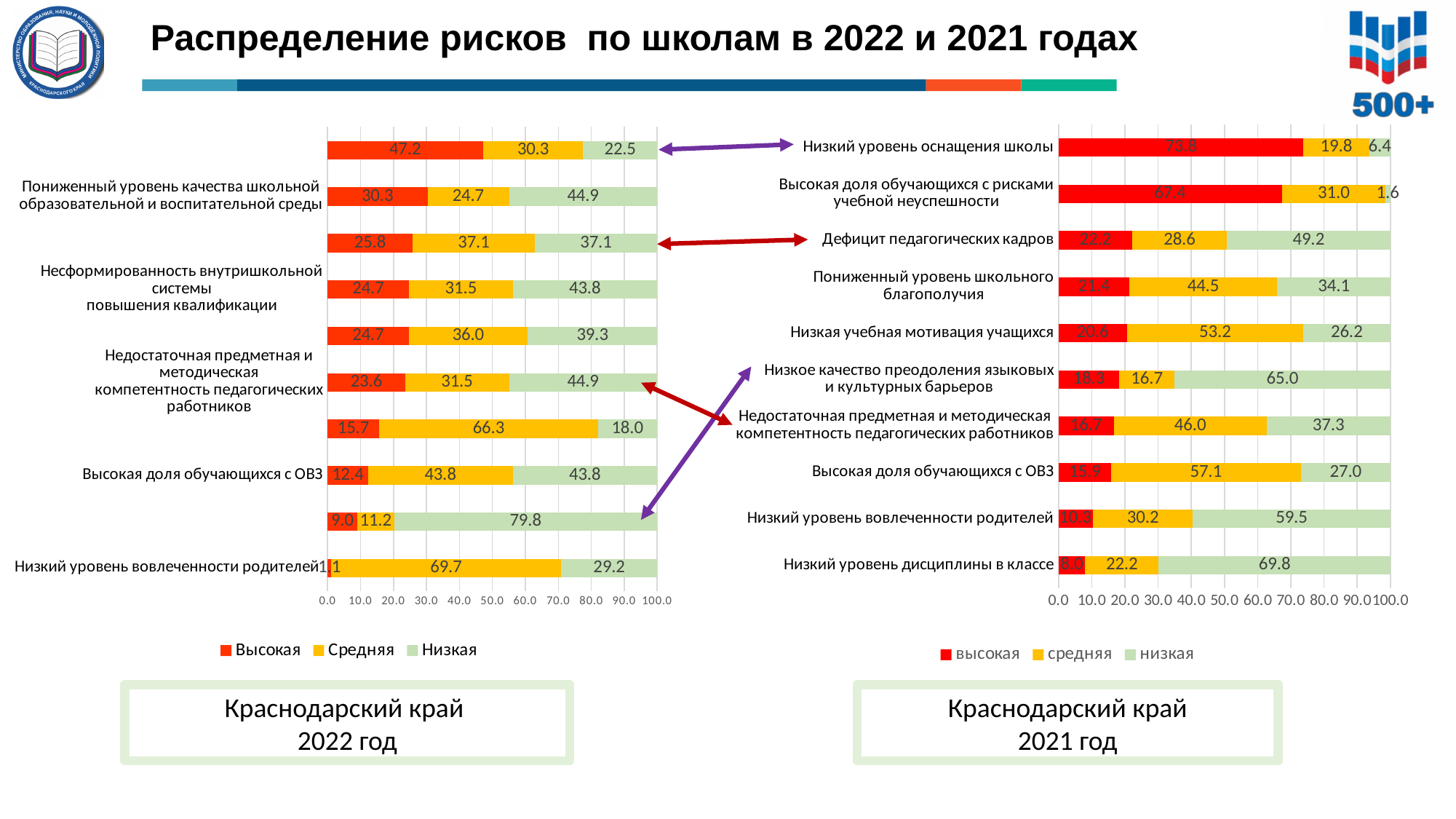
In the 2021 chart, what is the difference between the 'низкая' values for 'Низкий уровень дисциплины в классе' and 'Низкий уровень вовлеченности родителей'? 10.3 In the 2021 chart, which category has the lowest 'высокая' value? Низкий уровень дисциплины в классе How many categories (bars) does the 2021 chart show? 10 In the 2022 chart (Краснодарский край 2022 год), what is the 'Низкая' value for 'Низкий уровень вовлеченности родителей'? 29.2 What type of chart is used for the 2022 data? Stacked bar chart How many series does the legend of the 2022 chart list? 3 In the 2022 chart, what is the 'Высокая' value for 'Пониженный уровень качества школьной образовательной и воспитательной среды'? 30.3 In the 2021 chart (Краснодарский край 2021 год), what is the value of the 'высокая' series for 'Низкий уровень оснащения школы'? 73.8 In the 2021 chart, which category has the highest 'высокая' value? Низкий уровень оснащения школы In the 2021 chart, which is larger: the 'средняя' value for 'Низкая учебная мотивация учащихся' or for 'Дефицит педагогических кадров'? Низкая учебная мотивация учащихся In the 2021 chart, what is the 'средняя' value for 'Высокая доля обучающихся с ОВЗ'? 57.1 In the 2021 chart, what is the total of the stacked bar for 'Дефицит педагогических кадров'? 100.0